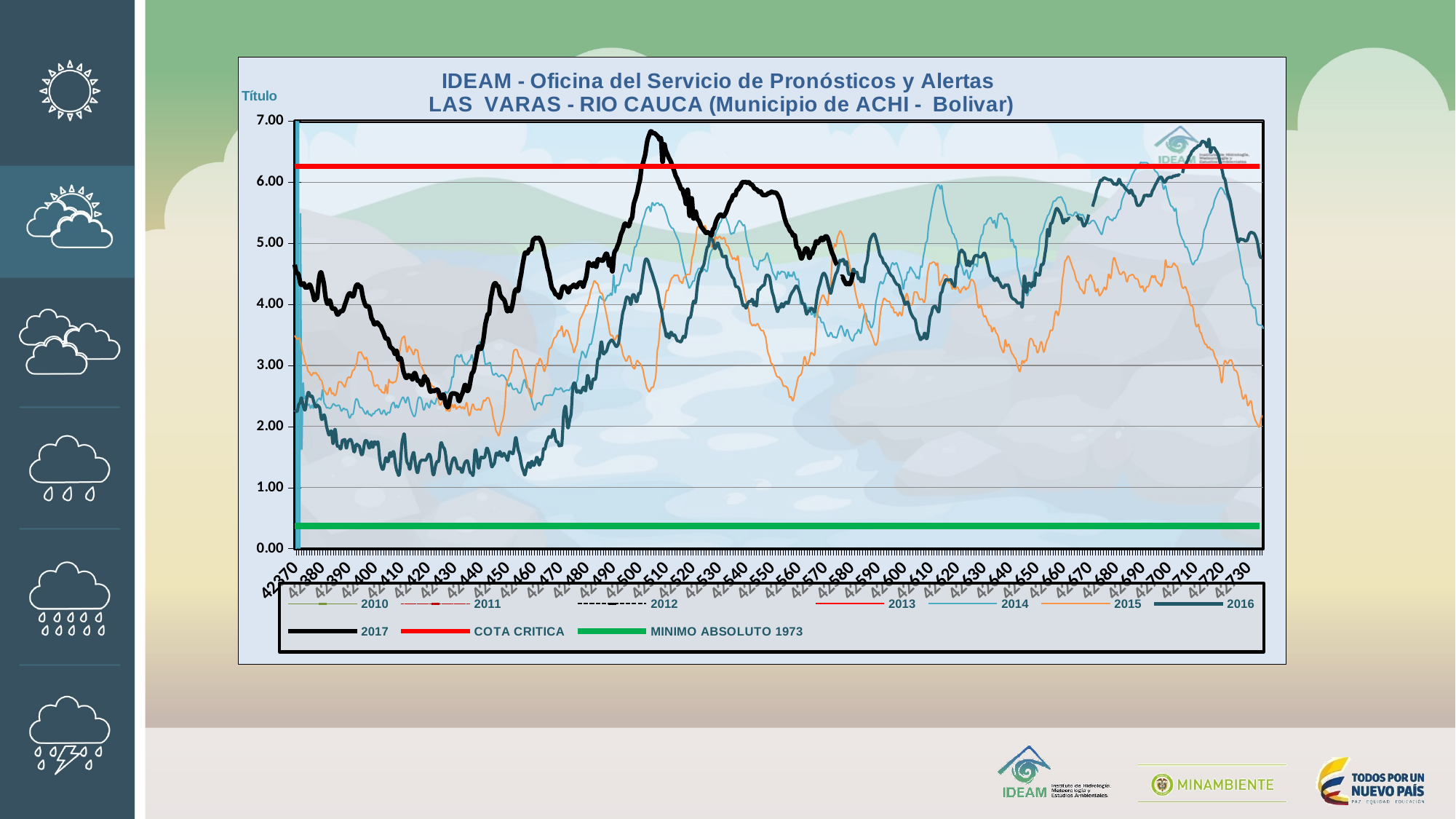
Is the value of the 2016 series at 42430 greater or less than 2.00? less Is the peak value of the 2017 series near 42510 greater or less than 6.00? greater Does the 2016 series end higher or lower than it starts along the x axis? higher What colour is the COTA CRITICA line? red What kind of chart is shown on the slide? line chart Is the value of the COTA CRITICA line greater or less than 6.00? greater How many series does the legend list? 10 At 42430, which series has the larger value, 2017 or 2016? 2017 Which reference line is higher on the chart, COTA CRITICA or MINIMO ABSOLUTO 1973? COTA CRITICA What station name appears in the second line of the chart title? LAS VARAS - RIO CAUCA (Municipio de ACHI - Bolivar)